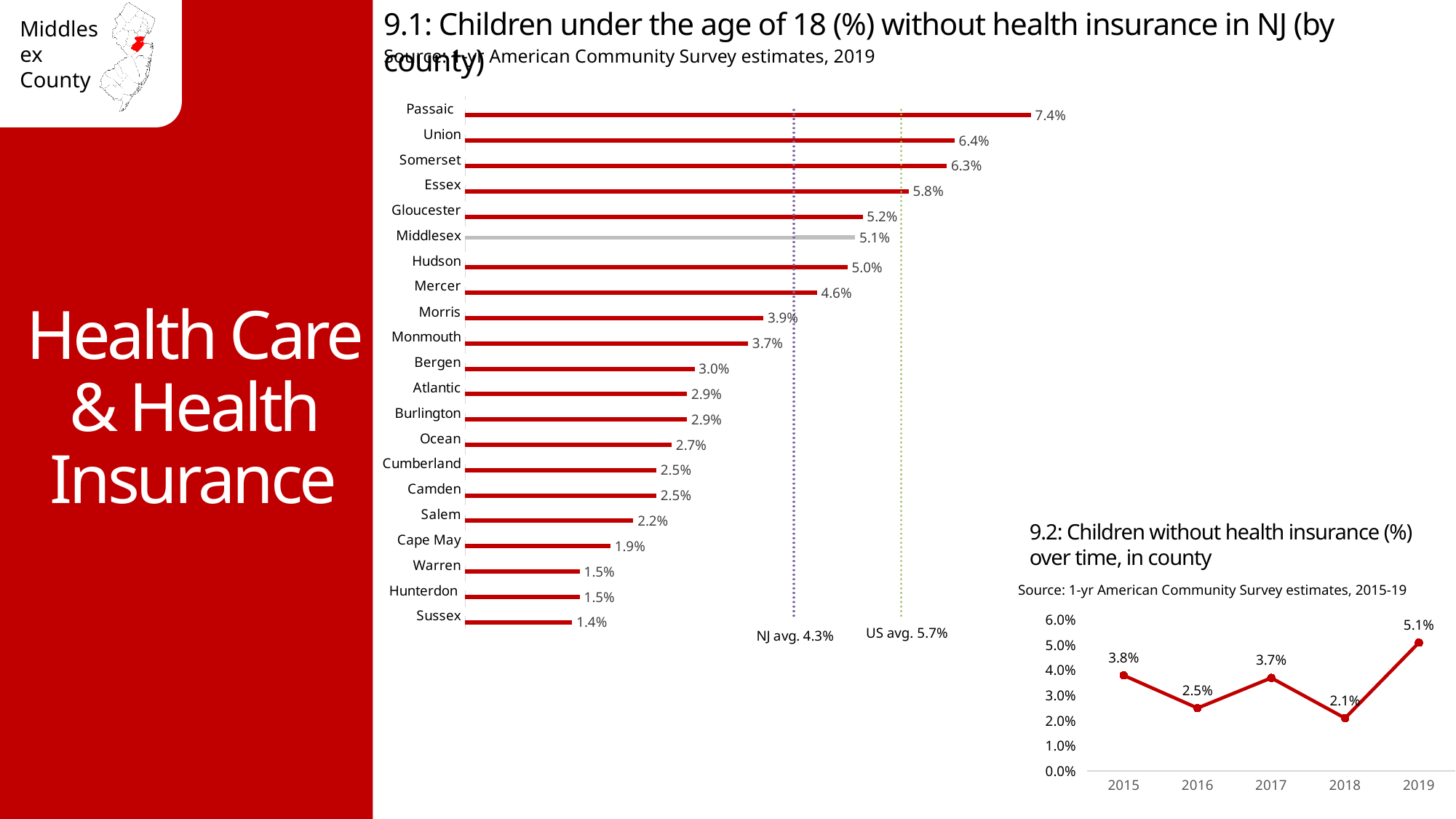
In chart 9.1, which is larger, the value for Hudson or the value for Mercer? Hudson In chart 9.2, what is the value for 2018? 2.1% What kind of chart is chart 9.1? Bar chart In chart 9.1, what is the NJ average shown by the dotted line? 4.3% In chart 9.1, which county has the highest percentage of children without health insurance? Passaic In chart 9.2, which year has the highest value? 2019 In chart 9.2, what is the difference between the values for 2019 and 2018? 3.0% In chart 9.1, what is the value for Middlesex? 5.1% In chart 9.1, what is the value for Essex? 5.8% In chart 9.1, how many counties are shown? 21 In chart 9.1, what is the difference between the values for Passaic and Union? 1.0% In chart 9.1, which county has the lowest percentage of children without health insurance? Sussex